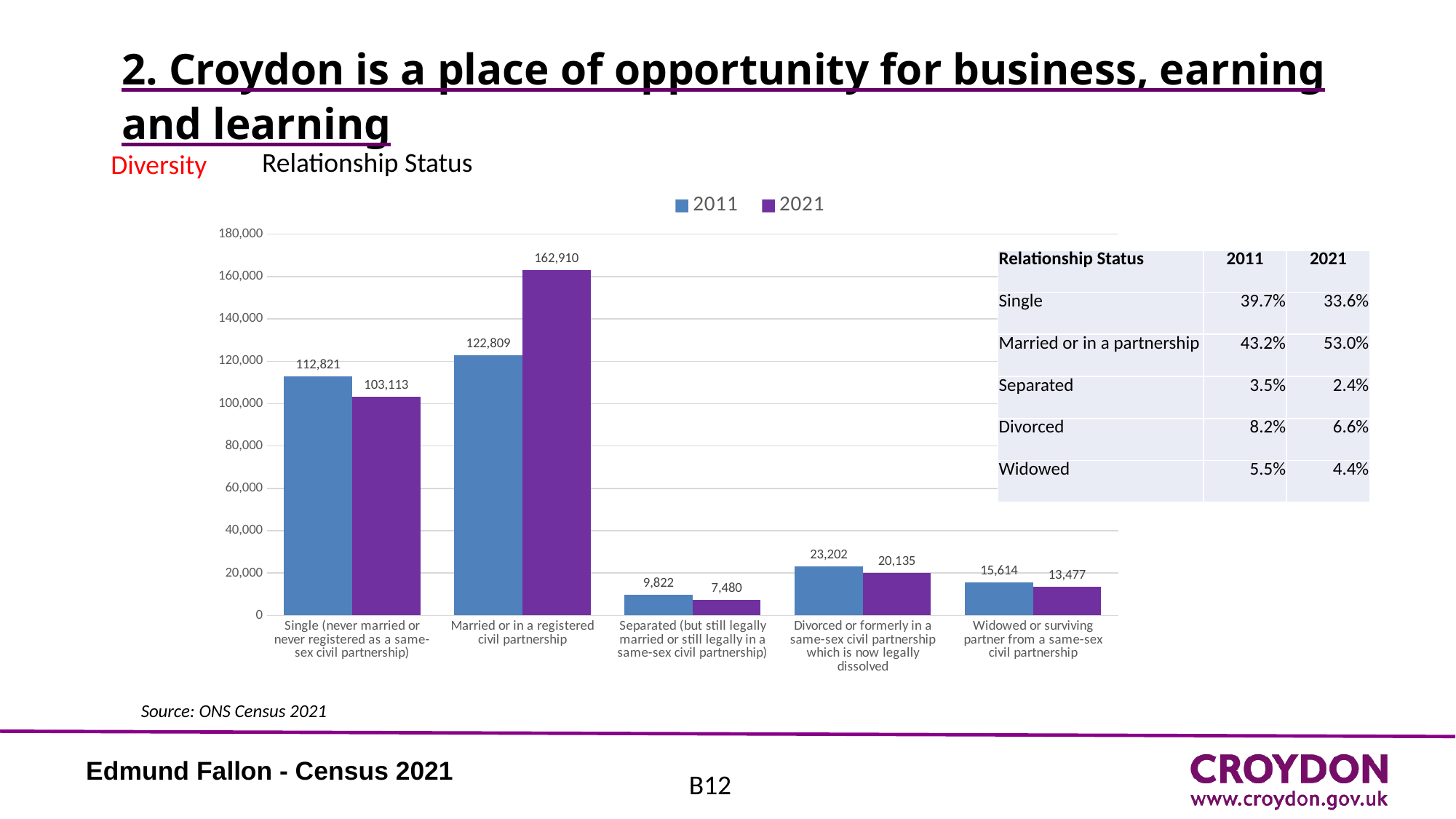
What kind of chart is shown on the slide? Bar chart What is the difference between the 2021 and 2011 values for Married or in a registered civil partnership? 40,101 How many categories are shown on the x axis of the chart? 5 Which category has the highest 2021 value? Married or in a registered civil partnership What is the 2011 value for Widowed or surviving partner from a same-sex civil partnership? 15,614 What is the 2021 value for Married or in a registered civil partnership? 162,910 How many series does the chart legend list? 2 Which is larger for Single: the 2011 value or the 2021 value? 2011 What is the 2021 value for Separated (but still legally married or still legally in a same-sex civil partnership)? 7,480 Which category has the lowest 2011 value? Separated (but still legally married or still legally in a same-sex civil partnership) What is the 2011 value for Single (never married or never registered as a same-sex civil partnership)? 112,821 What is the difference between the 2011 and 2021 values for Divorced or formerly in a same-sex civil partnership which is now legally dissolved? 3,067